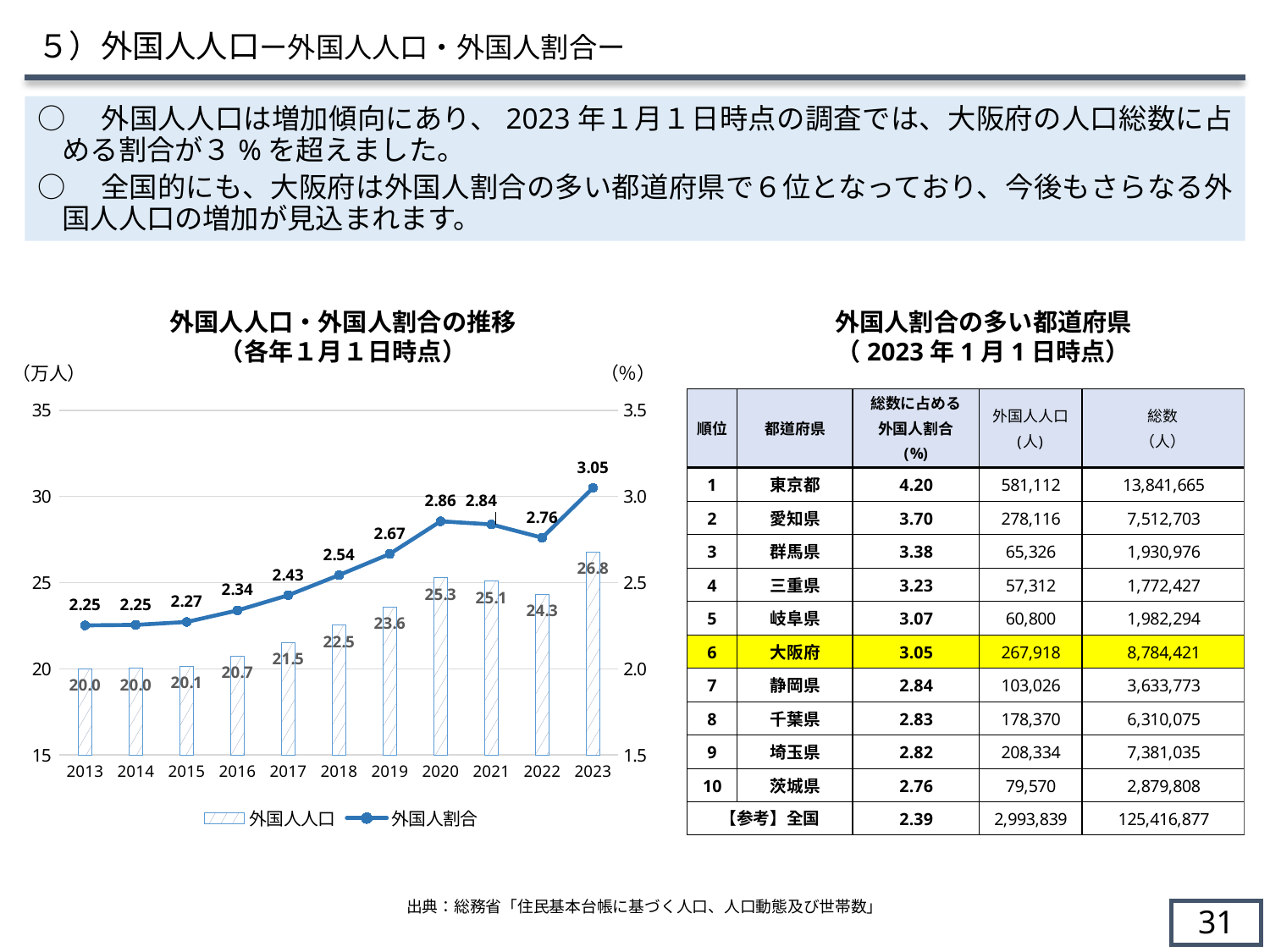
In the chart 外国人人口・外国人割合の推移, what is the 外国人割合 for 2020? 2.86 In the chart 外国人人口・外国人割合の推移, what is the 外国人人口 for 2017? 21.5 In the chart 外国人人口・外国人割合の推移, which year has the highest 外国人割合? 2023 In the chart 外国人人口・外国人割合の推移, is the 外国人人口 for 2019 greater or less than 25? less How many series does the legend of the chart 外国人人口・外国人割合の推移 list? 2 What kind of chart is 外国人人口・外国人割合の推移? Combined bar and line chart How many years are shown on the x axis of the chart 外国人人口・外国人割合の推移? 11 In the chart 外国人人口・外国人割合の推移, which year has the larger 外国人人口, 2020 or 2021? 2020 In the chart 外国人人口・外国人割合の推移, by how much did the 外国人割合 increase from 2022 to 2023? 0.29 In the chart 外国人人口・外国人割合の推移, what is the value of 外国人人口 for 2023? 26.8 In the chart 外国人人口・外国人割合の推移, what is the difference in 外国人人口 between 2023 and 2013? 6.8 In the chart 外国人人口・外国人割合の推移, which year has the highest 外国人人口? 2023